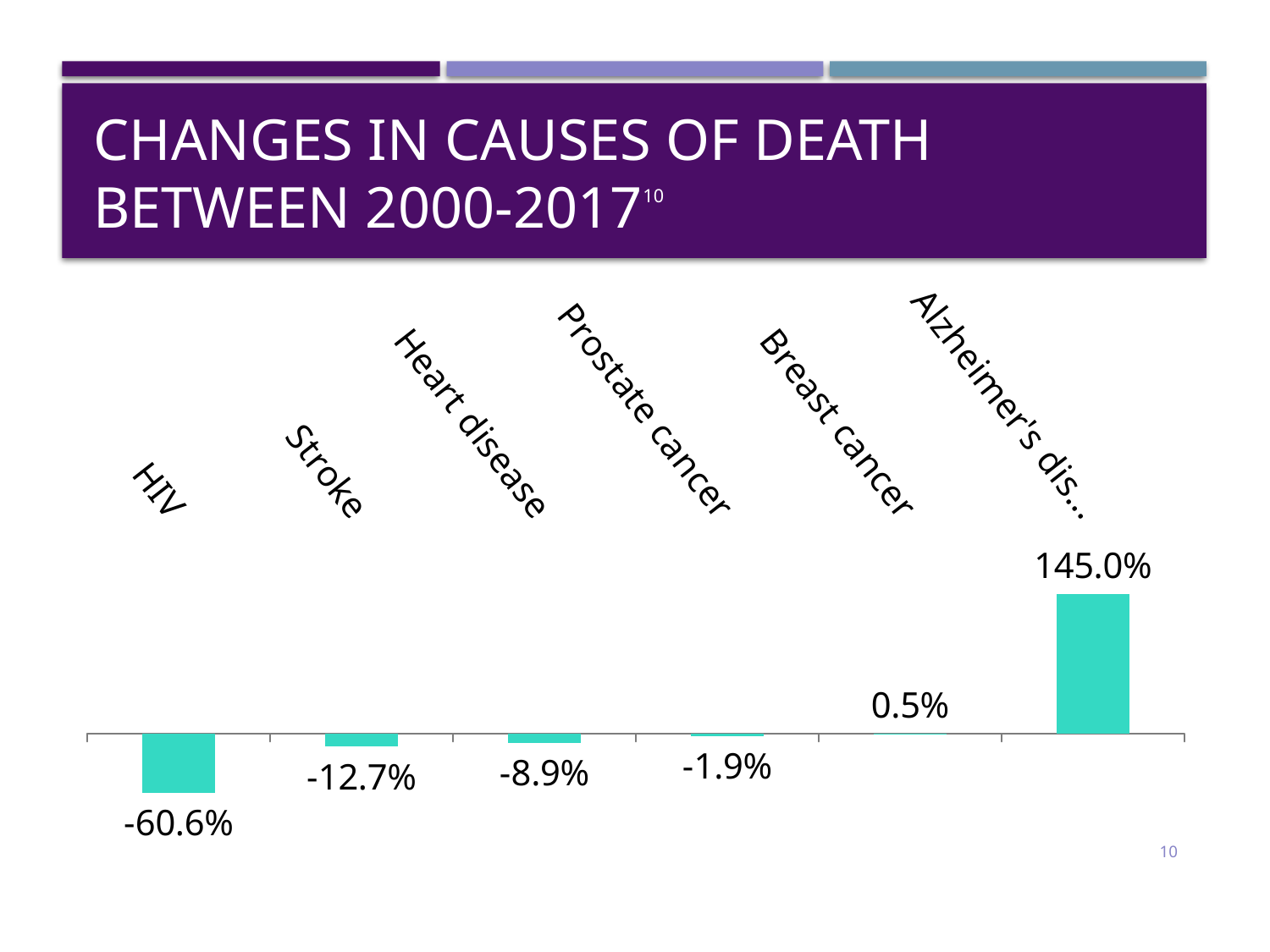
What kind of chart is shown on the slide? Bar chart What is the value for Heart disease? -8.9% Which cause of death has the lowest value? HIV What is the difference between the values for Stroke and Heart disease? 3.8 percentage points What is the value for Stroke? -12.7% How many causes of death are shown in the chart? 6 Which cause of death has the highest value? Alzheimer's disease What is the value for Breast cancer? 0.5% What is the value for Alzheimer's disease? 145.0% Which is larger, the value for Breast cancer or the value for Prostate cancer? Breast cancer What is the value for Prostate cancer? -1.9% What is the value for HIV? -60.6%